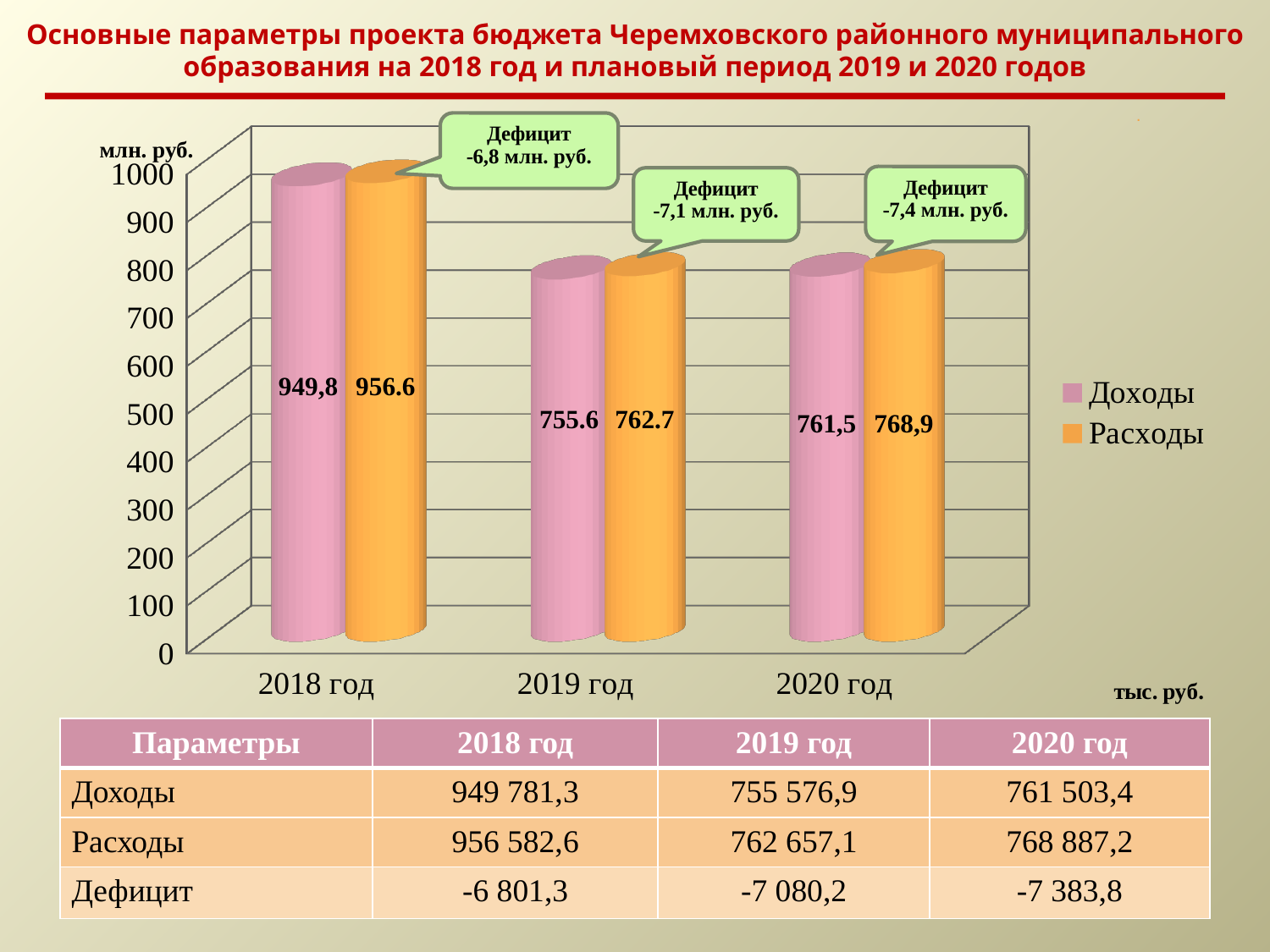
In which year is Доходы highest? 2018 год What kind of chart is shown on the slide? bar chart Do the values for Доходы rise or fall from 2018 год to 2019 год? fall What is the value for Расходы in 2020 год? 768,9 What is the value for Доходы in 2018 год? 949,8 In which year is Расходы lowest? 2019 год By how much do Расходы exceed Доходы in 2019 год? 7.1 How many series does the chart legend list? 2 How many years are shown on the x axis of the chart? 3 What is the value for Расходы in 2019 год? 762.7 Is the value for Расходы in 2018 год greater or less than 900? greater Which is larger in 2020 год, Доходы or Расходы? Расходы